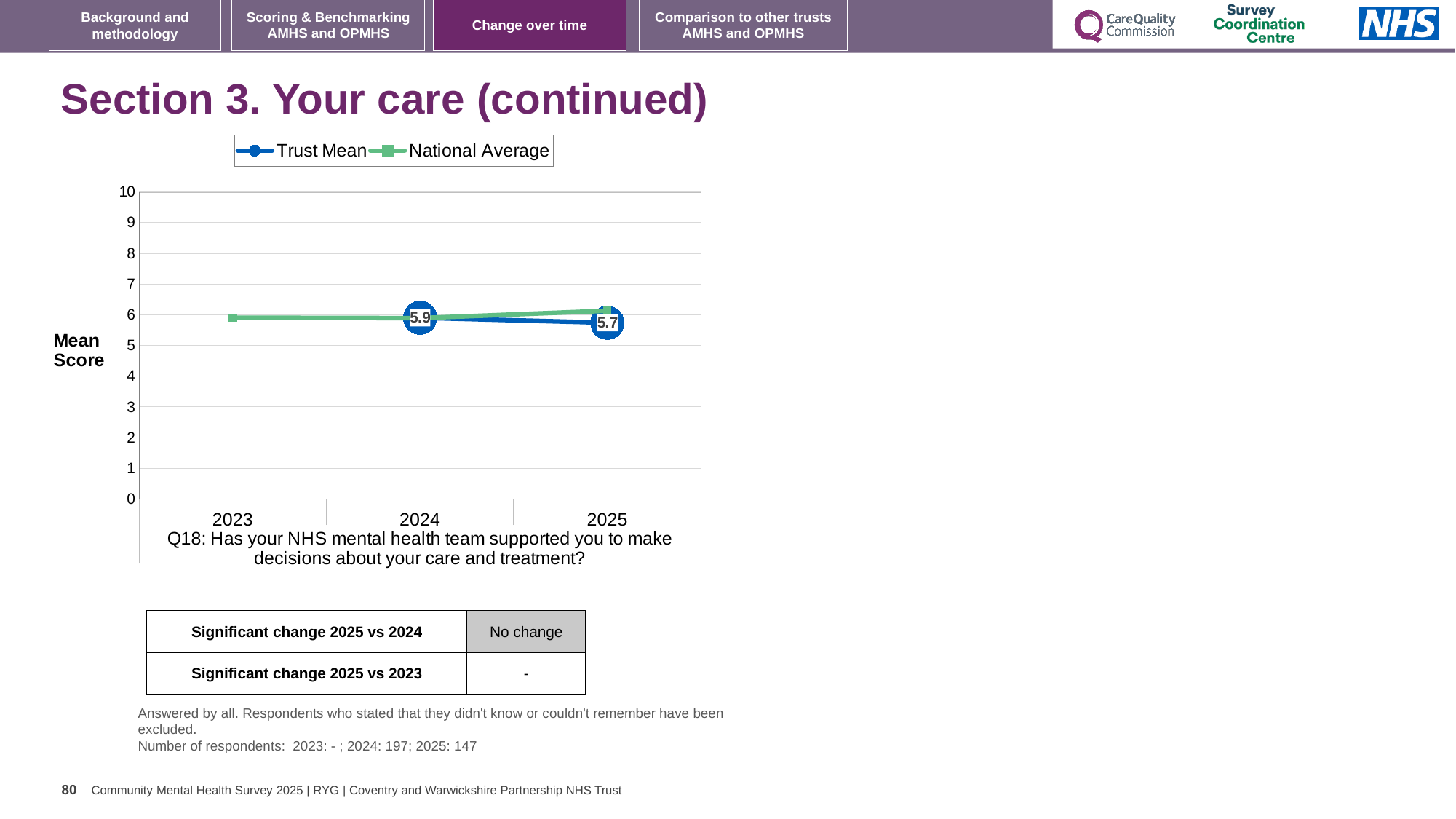
What is the difference between the Trust Mean in 2024 and in 2025? 0.2 What is the label on the y axis of the chart? Mean Score What is the Trust Mean value for 2024? 5.9 Is the National Average value for 2025 greater or less than 5? greater What is the Trust Mean value for 2025? 5.7 Does the Trust Mean rise or fall from 2024 to 2025? fall How many series does the legend list? 2 Which year has the higher Trust Mean, 2024 or 2025? 2024 Is the National Average value for 2023 greater or less than 7? less How many years are shown on the x axis? 3 What kind of chart is shown on the slide? line chart In which year is the Trust Mean highest? 2024